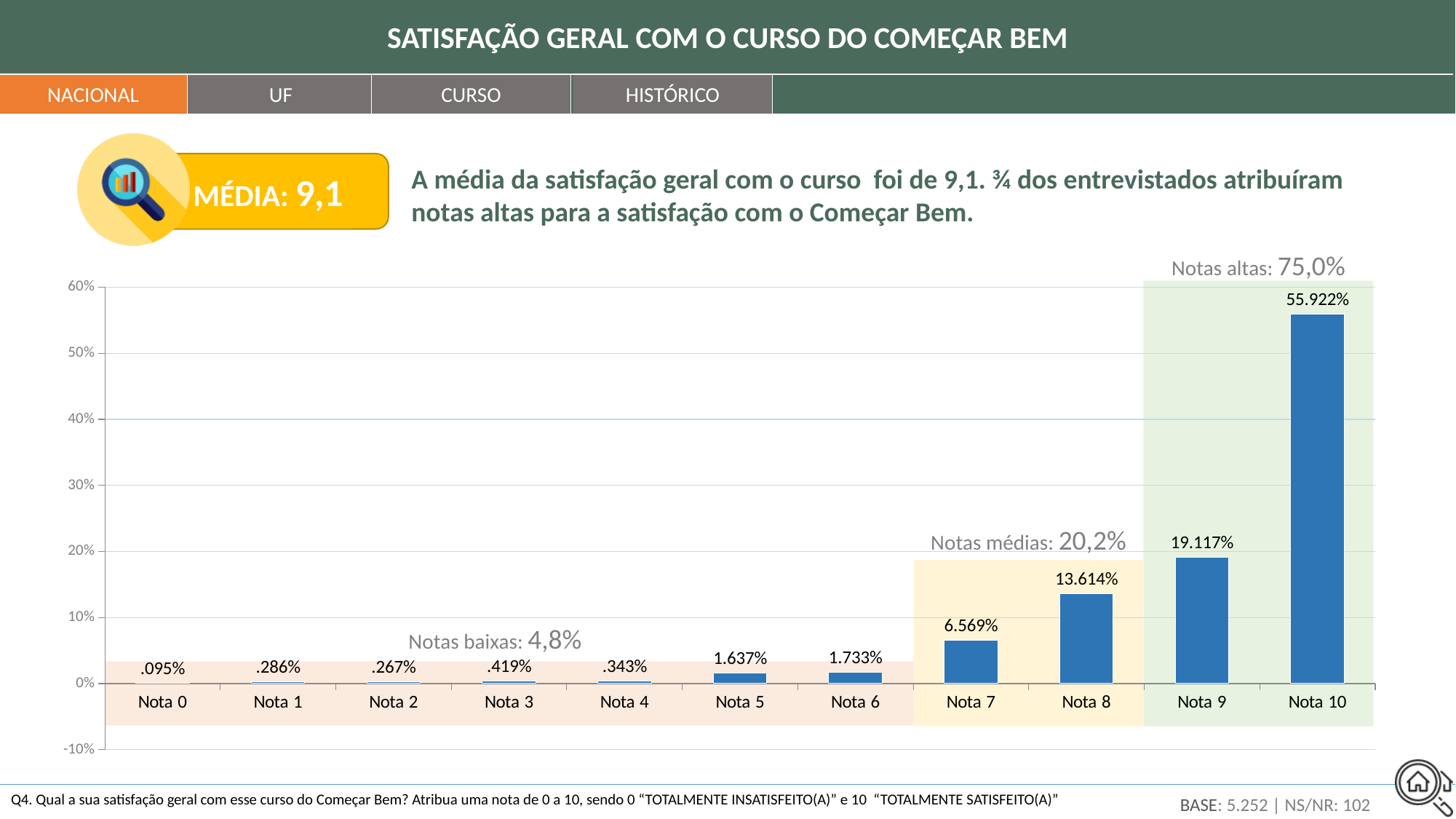
Which category has the highest value? Nota 10 Which is larger, the value for Nota 7 or the value for Nota 8? Nota 8 Which category has the lowest value? Nota 0 What is the value for Nota 10? 55.922% What percentage is shown for the 'Notas altas' group? 75,0% How many categories are shown on the x axis? 11 What is the value for Nota 0? .095% What is the difference between the values for Nota 10 and Nota 9? 36.805% What kind of chart is shown on the slide? bar chart Is the value for Nota 9 greater or less than 20%? less What is the value for Nota 8? 13.614% What percentage is shown for the 'Notas baixas' group? 4,8%